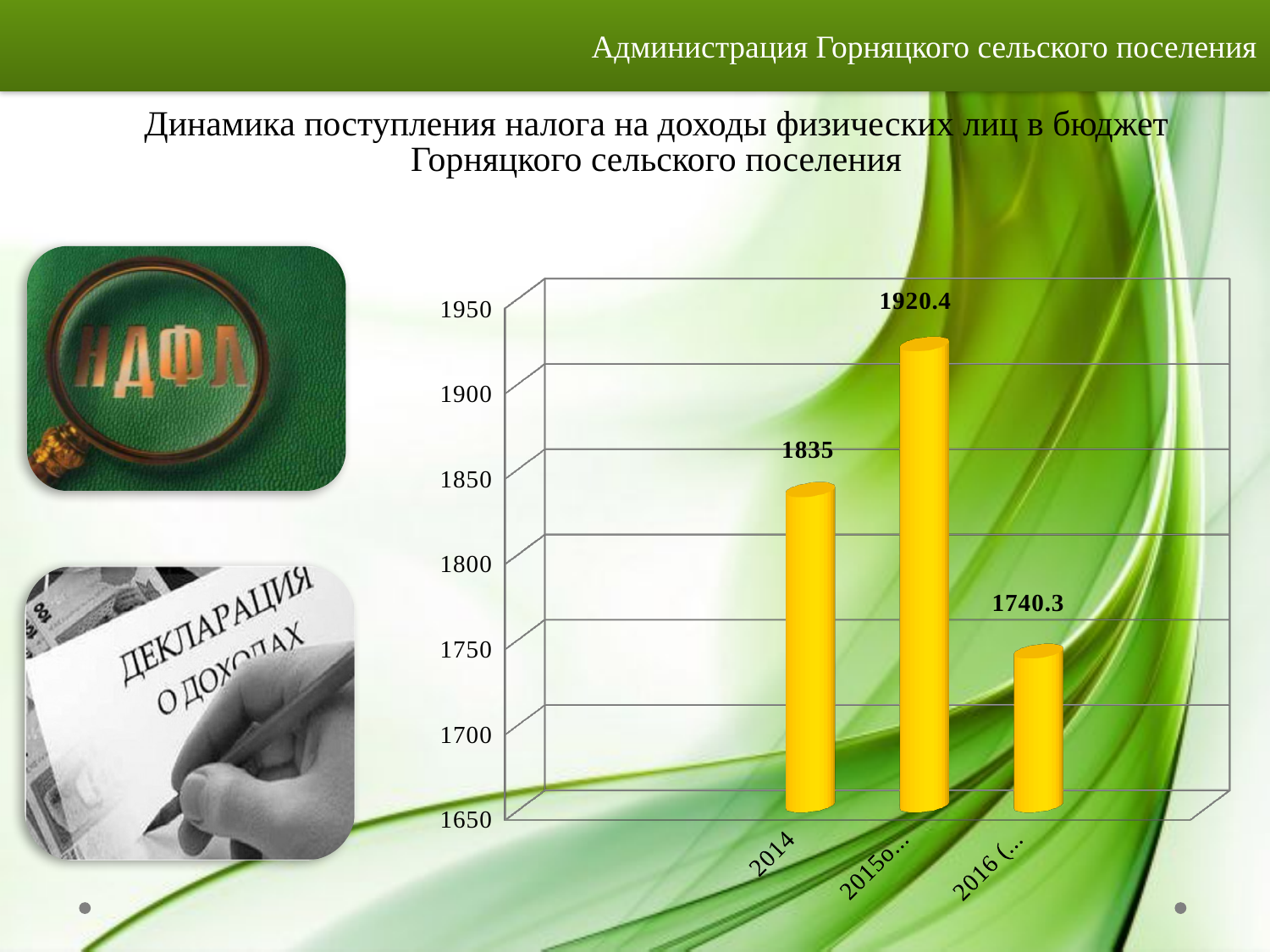
Is the value for 2016 greater or less than 1750? less What is the value for 2014? 1835 What is the highest value labelled on the vertical axis? 1950 What is the difference between the 2015 value and the 2014 value? 85.4 What is the value for the 2015 bar? 1920.4 What is the value for the 2016 bar? 1740.3 How many bars are shown in the chart? 3 What kind of chart is shown on the slide? bar chart What is the difference between the 2014 value and the 2016 value? 94.7 Which year has the lowest value? 2016 Which is larger, the value for 2014 or the value for 2016? 2014 Which year has the highest value? 2015